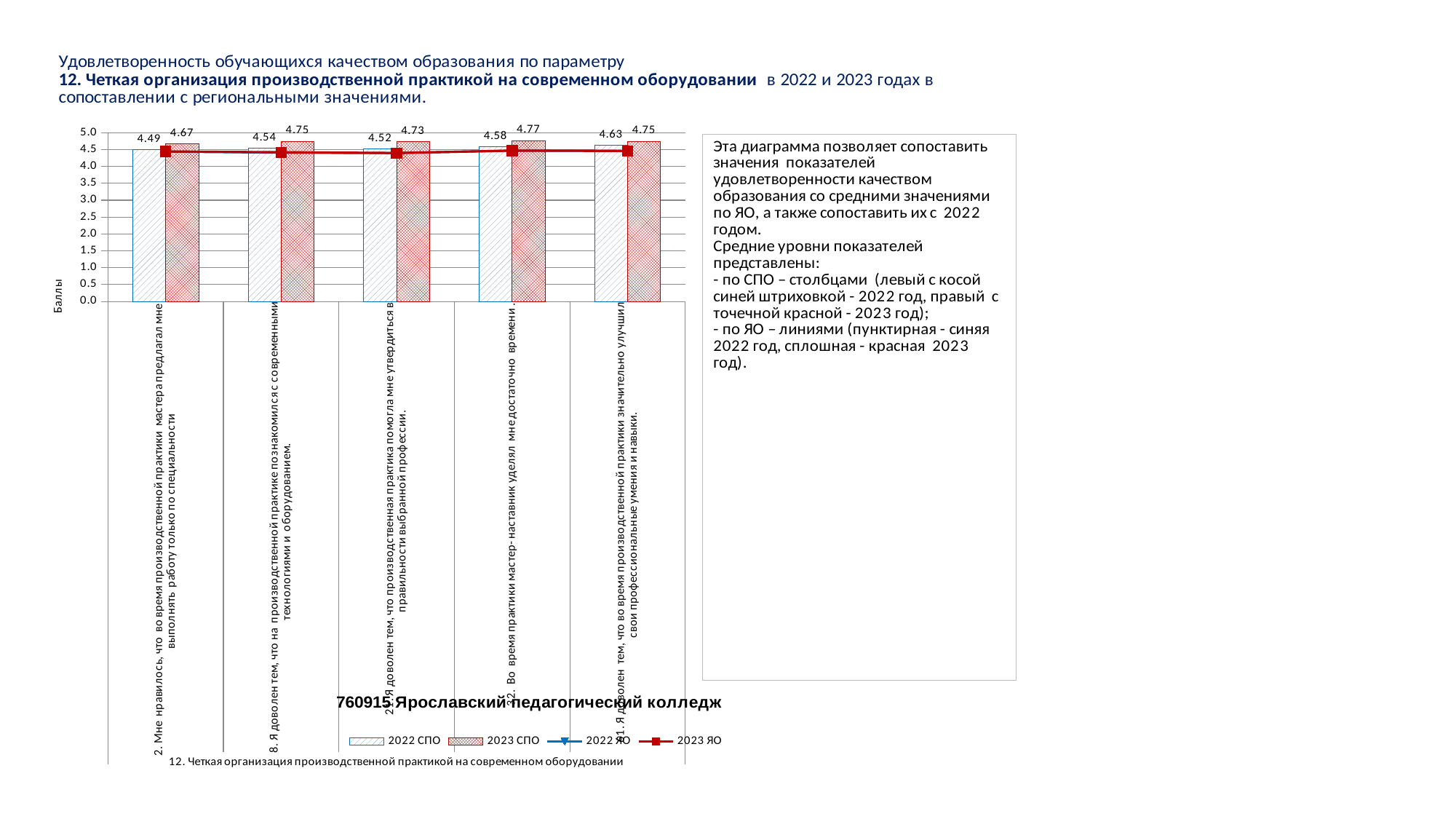
For the category "2. Мне нравилось, что во время производственной практики мастера предлагал мне выполнять работу только по специальности", what is the difference between the 2023 СПО and 2022 СПО values? 0.18 What is the 2023 СПО value for the category "32. Во время практики мастер-наставник уделял мне достаточно времени"? 4.77 Is the 2023 ЯО line value for the first category (2.) greater or less than 4.0? greater What is the title of the vertical axis? Баллы Which category has the lowest 2022 СПО value? 2. Мне нравилось, что во время производственной практики мастера предлагал мне выполнять работу только по специальности (4.49) How many categories are shown on the x axis of the chart? 5 Is the 2023 СПО value higher than the 2022 СПО value in every category? Yes What is the 2022 СПО value for the category "8. Я доволен тем, что на производственной практике познакомился с современными технологиями и оборудованием"? 4.54 How many series does the chart legend list? 4 Which category has the highest 2023 СПО value? 32. Во время практики мастер-наставник уделял мне достаточно времени (4.77) Which is larger: the 2023 СПО value for category 8 or for category 21? Category 8 (4.75 vs 4.73)